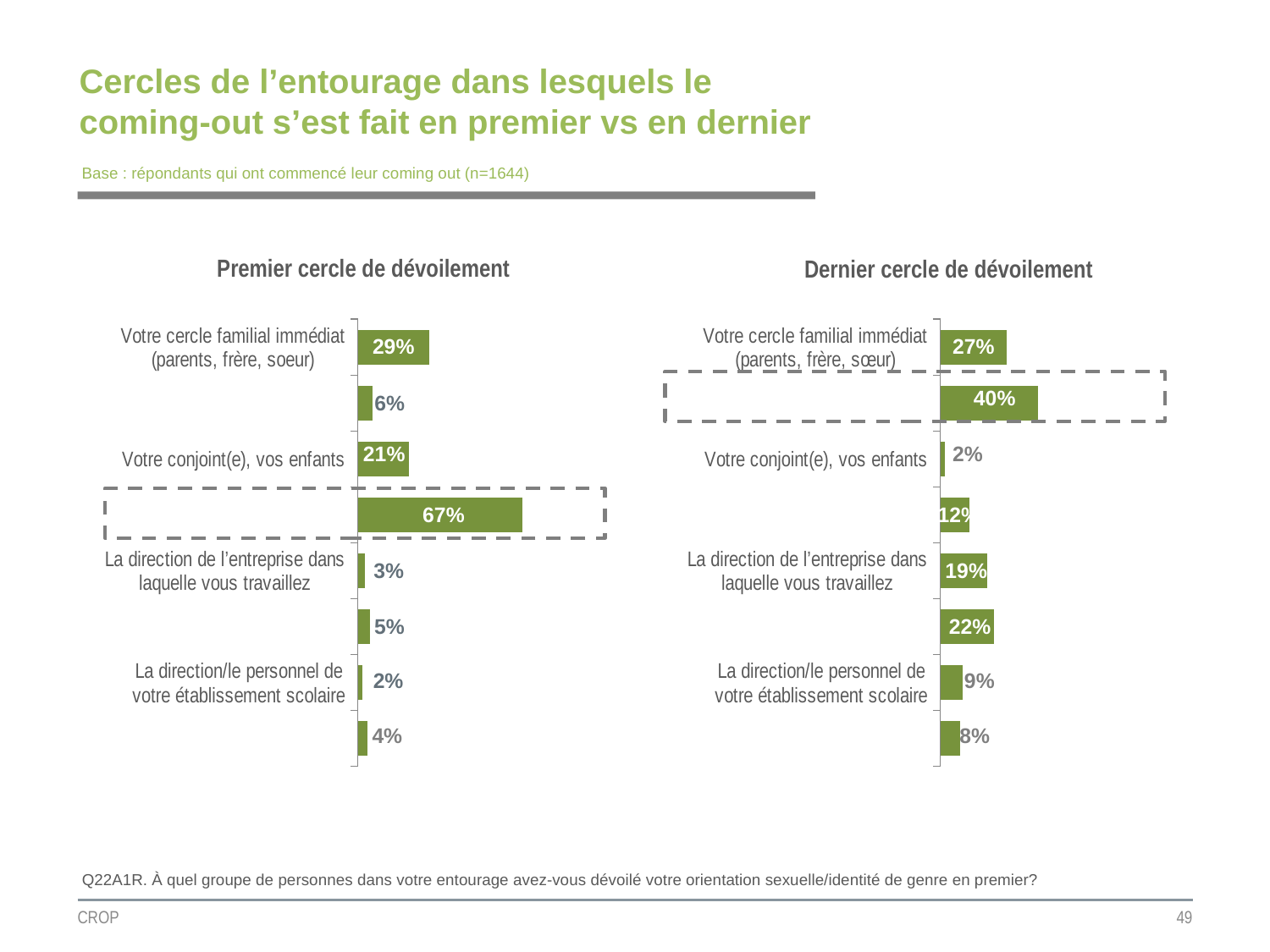
In the 'Premier cercle de dévoilement' chart, what is the value for 'Votre cercle familial immédiat (parents, frère, soeur)'? 29% In the 'Premier cercle de dévoilement' chart, what is the value for 'Votre conjoint(e), vos enfants'? 21% Which chart shows a larger value for 'La direction de l'entreprise dans laquelle vous travaillez', 'Premier cercle de dévoilement' or 'Dernier cercle de dévoilement'? Dernier cercle de dévoilement What kind of chart is used for 'Premier cercle de dévoilement'? bar chart In the 'Premier cercle de dévoilement' chart, what is the largest value shown on any bar? 67% In the 'Dernier cercle de dévoilement' chart, what is the value for 'Votre conjoint(e), vos enfants'? 2% In the 'Dernier cercle de dévoilement' chart, what is the value for 'Votre cercle familial immédiat (parents, frère, sœur)'? 27% How many bars does the 'Premier cercle de dévoilement' chart contain? 8 In the 'Dernier cercle de dévoilement' chart, what is the value for 'La direction de l'entreprise dans laquelle vous travaillez'? 19% What is the difference between the 'Votre conjoint(e), vos enfants' values in the 'Premier cercle de dévoilement' chart and the 'Dernier cercle de dévoilement' chart? 19% In the 'Dernier cercle de dévoilement' chart, what is the largest value shown on any bar? 40% In the 'Premier cercle de dévoilement' chart, what is the value for 'La direction/le personnel de votre établissement scolaire'? 2%